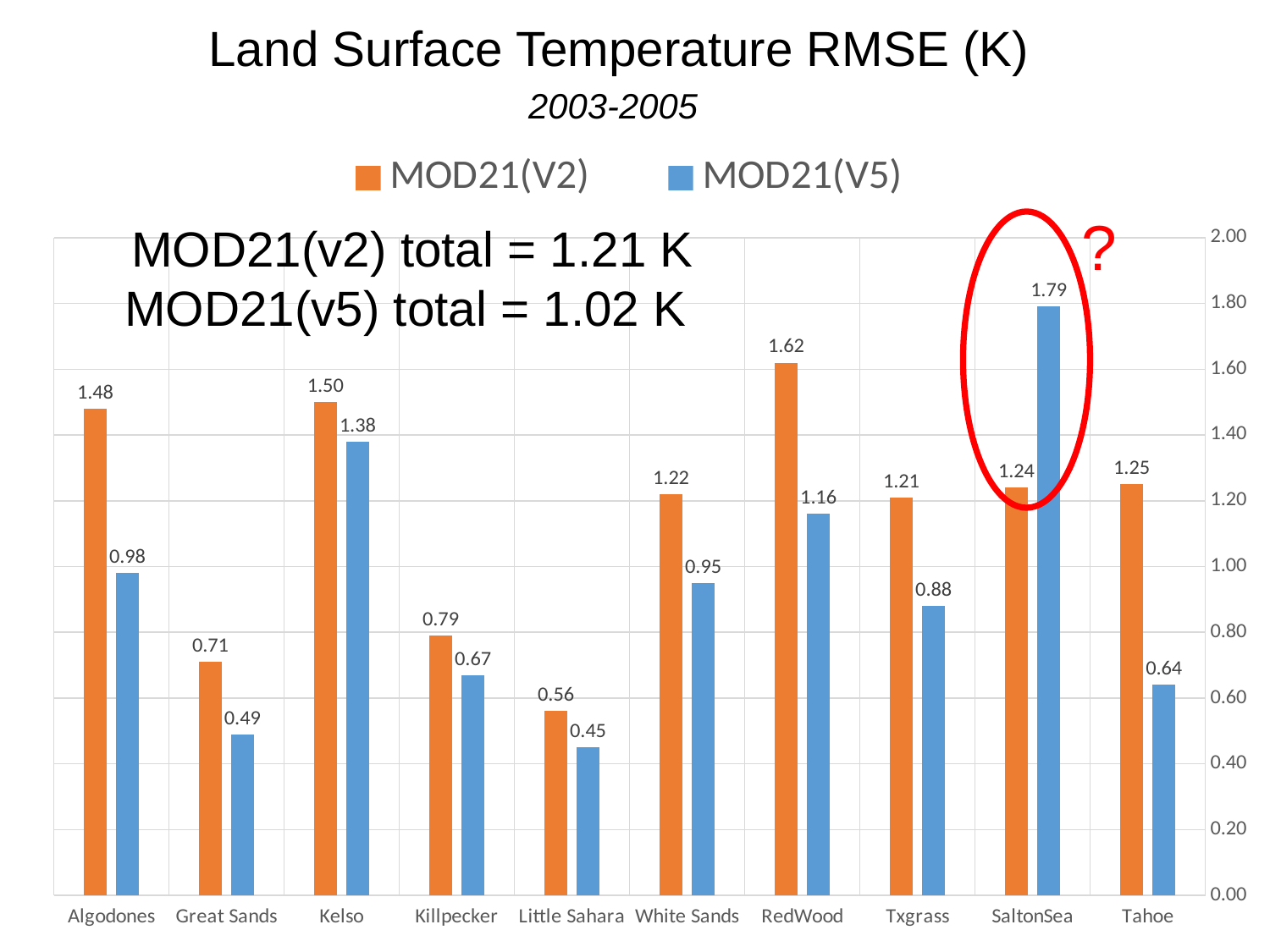
Which is larger for White Sands, the MOD21(V2) or the MOD21(V5) RMSE? MOD21(V2) What is the difference between the MOD21(V5) and MOD21(V2) RMSE values for SaltonSea? 0.55 What is the MOD21(v5) total stated in the text on the chart? 1.02 K What is the MOD21(V5) RMSE value for SaltonSea? 1.79 Which site is circled in red on the chart? SaltonSea How many series does the legend list? 2 What kind of chart is shown on the slide? Bar chart What is the MOD21(V2) RMSE value for Kelso? 1.50 Which site has the lowest MOD21(V5) RMSE? Little Sahara What is the MOD21(V5) RMSE value for Tahoe? 0.64 How many sites are shown on the x axis? 10 Which site has the highest MOD21(V2) RMSE? RedWood